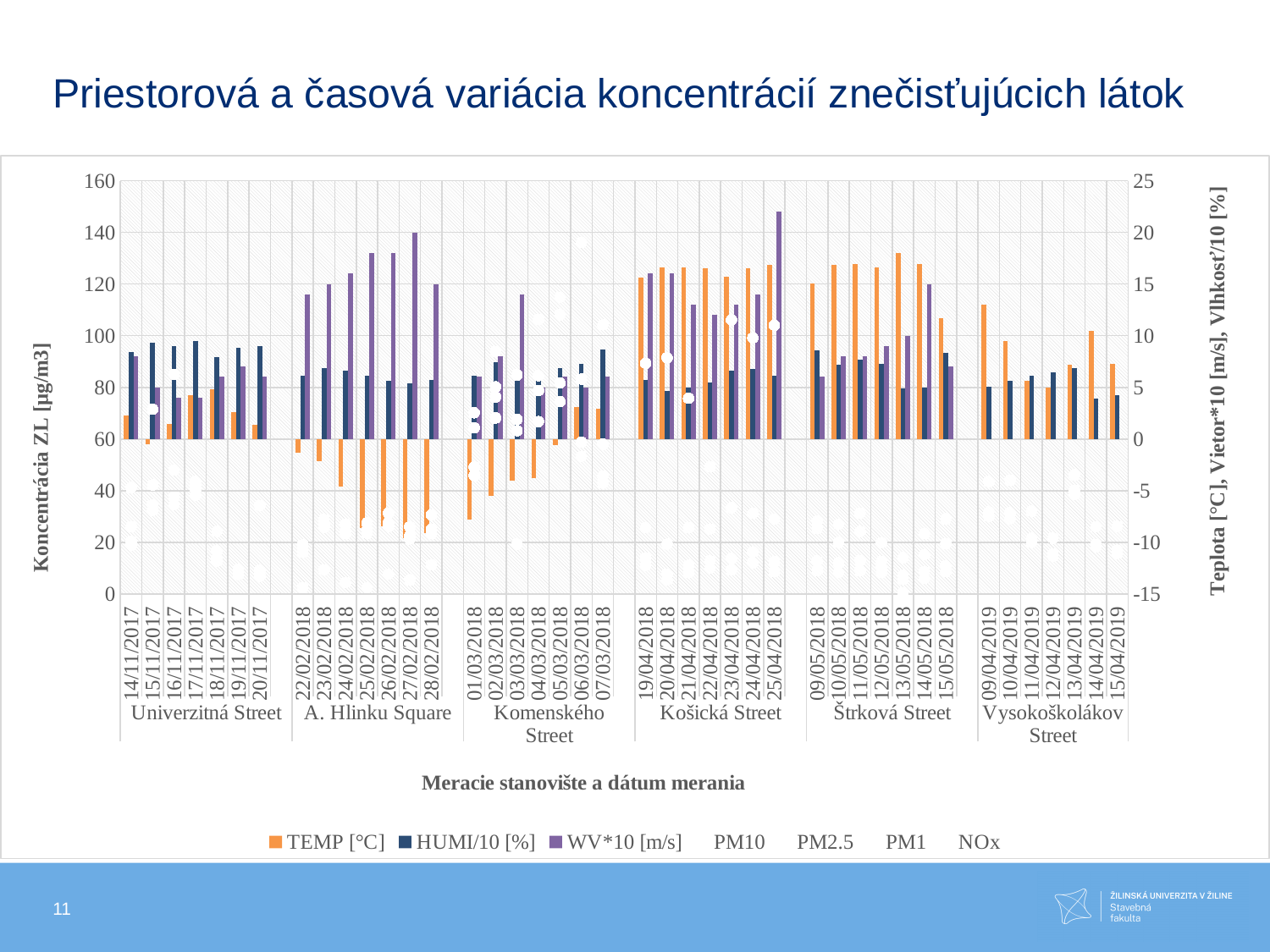
Is the TEMP [°C] value on 25/02/2018 greater or less than -5? less What is the maximum value shown on the right vertical axis? 25 How many measurement dates are shown for Univerzitná Street? 7 Which is larger, the TEMP [°C] value on 13/05/2018 or on 25/02/2018? 13/05/2018 How many series does the legend list? 7 Is the TEMP [°C] value on 13/05/2018 greater or less than 15? greater How many measurement sites are shown along the x axis? 6 What kind of chart is shown on the slide? combination bar and line chart What is the title of the left vertical axis? Koncentrácia ZL [µg/m3] Is the WV*10 [m/s] value on 25/04/2018 greater or less than 20 on the right axis? greater On which date is the WV*10 [m/s] bar the highest? 25/04/2018